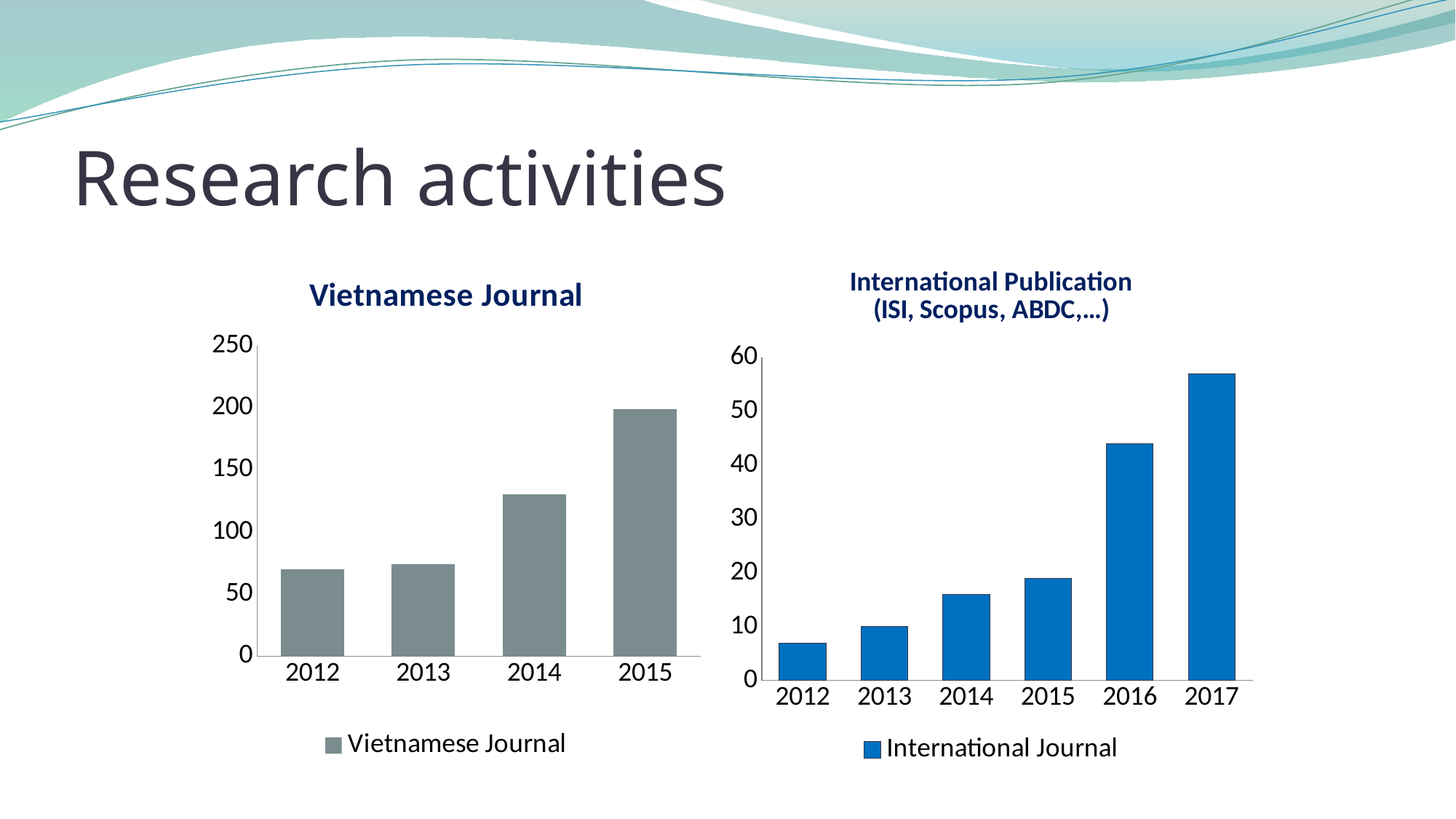
In the Vietnamese Journal chart, which year has the highest value? 2015 How many years are shown on the x axis of the International Publication (ISI, Scopus, ABDC,...) chart? 6 In the Vietnamese Journal chart, do the values rise or fall from 2012 to 2015? Rise In the International Publication (ISI, Scopus, ABDC,...) chart, is the value for 2016 greater or less than 50? less In the International Publication (ISI, Scopus, ABDC,...) chart, is the value for 2017 greater or less than 50? greater How many series does the legend of the International Publication (ISI, Scopus, ABDC,...) chart list? 1 In the International Publication (ISI, Scopus, ABDC,...) chart, which year has the highest value? 2017 In the Vietnamese Journal chart, is the value for 2015 greater or less than 150? greater In the Vietnamese Journal chart, which is larger, the value for 2013 or the value for 2014? 2014 In the International Publication (ISI, Scopus, ABDC,...) chart, which year has the lowest value? 2012 What kind of chart is the Vietnamese Journal chart? Bar chart How many years are shown on the x axis of the Vietnamese Journal chart? 4